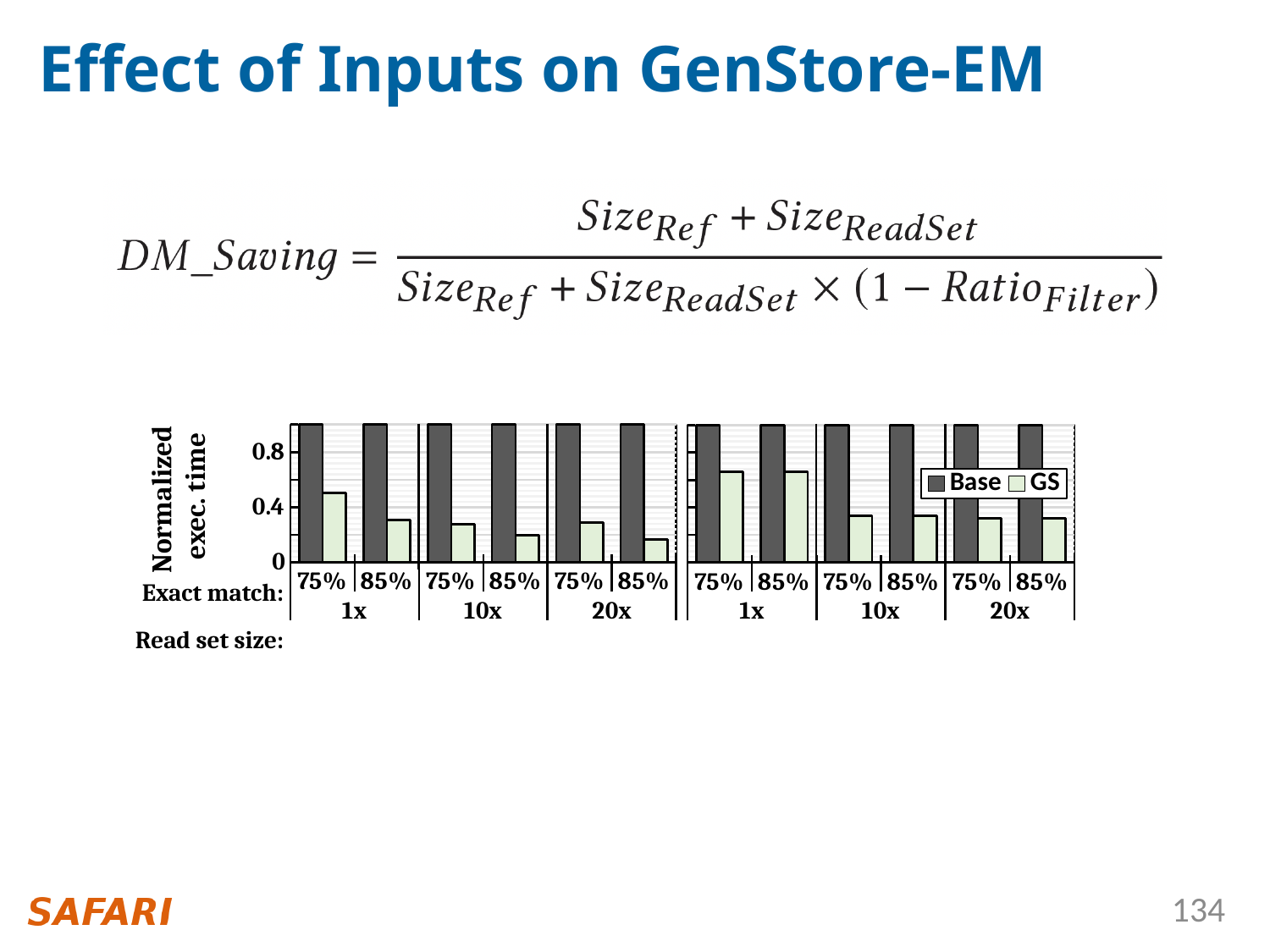
What is the label of the chart's y axis? Normalized exec. time What are the two series named in the chart's legend? Base and GS What kind of chart is shown on the slide? bar chart In the right panel, at 75% exact match, which read set size has the larger GS value, 1x or 10x? 1x In the left panel, is the GS value for read set size 1x at 85% exact match greater or less than 0.4? less In the right panel, is the GS value for read set size 10x at 75% exact match greater or less than 0.4? less How many read set size groups (1x, 10x, 20x) are labeled in the left panel of the chart? 3 In the left panel, which read set size and exact match combination has the highest GS bar? 1x, 75% In the right panel, is the GS value for read set size 1x at 75% exact match greater or less than 0.4? greater How many series does the chart's legend list? 2 In the left panel, for read set size 1x, which exact match setting has the larger GS value, 75% or 85%? 75%